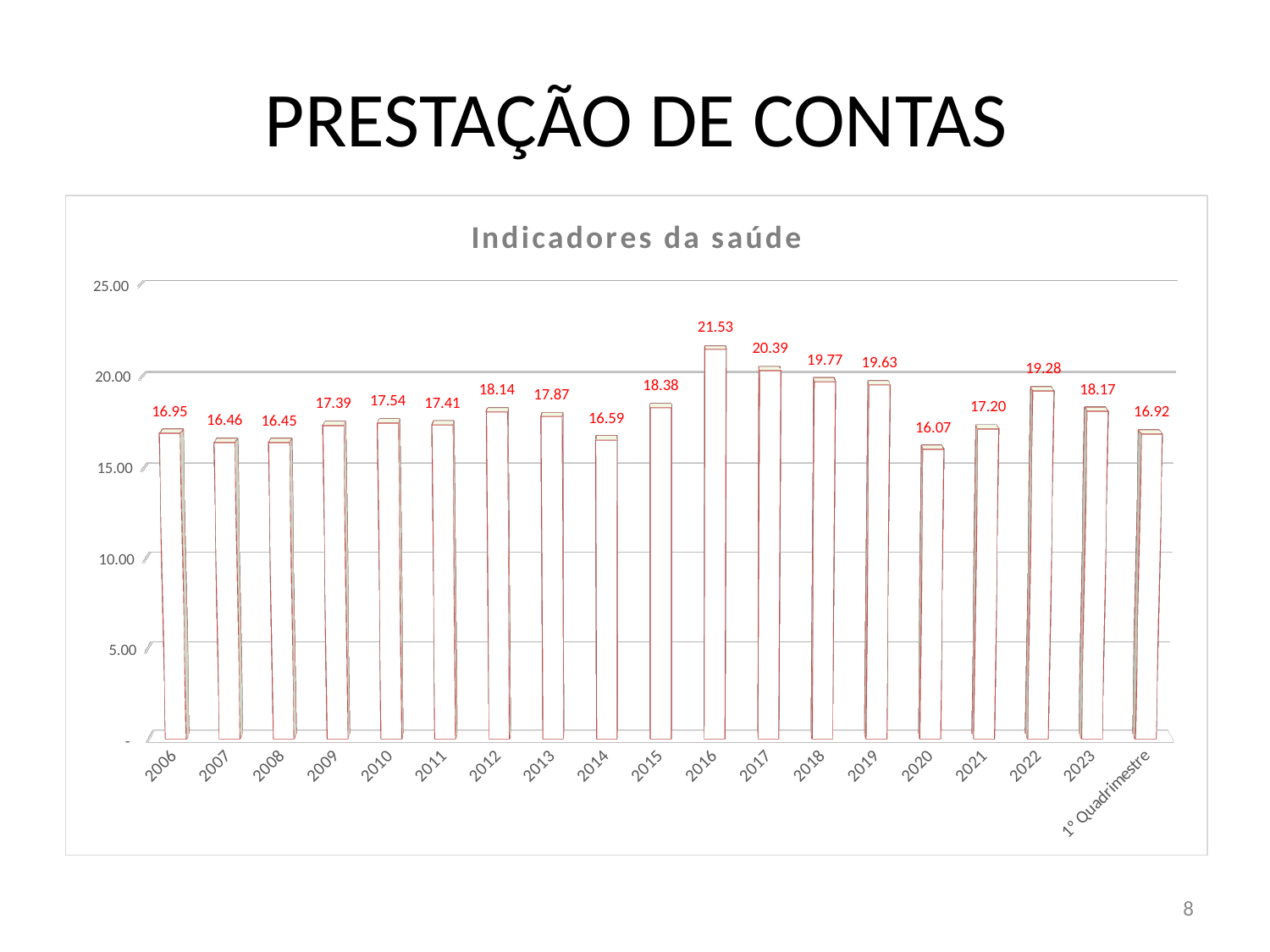
What is the difference between the values for 2016 and 2017 in the 'Indicadores da saúde' chart? 1.14 What is the difference between the values for 2023 and 2020 in the 'Indicadores da saúde' chart? 2.10 What is the value for 2020 in the 'Indicadores da saúde' chart? 16.07 What is the title of the chart on the slide? Indicadores da saúde How many categories are plotted in the 'Indicadores da saúde' chart? 19 What kind of chart is 'Indicadores da saúde'? bar chart What is the value for 2016 in the 'Indicadores da saúde' chart? 21.53 Which category has the highest value in the 'Indicadores da saúde' chart? 2016 Which is larger in the 'Indicadores da saúde' chart, the value for 2012 or the value for 2013? 2012 Which category has the lowest value in the 'Indicadores da saúde' chart? 2020 What is the value for '1° Quadrimestre' in the 'Indicadores da saúde' chart? 16.92 Is the value for 2017 in the 'Indicadores da saúde' chart greater or less than 20.00? greater